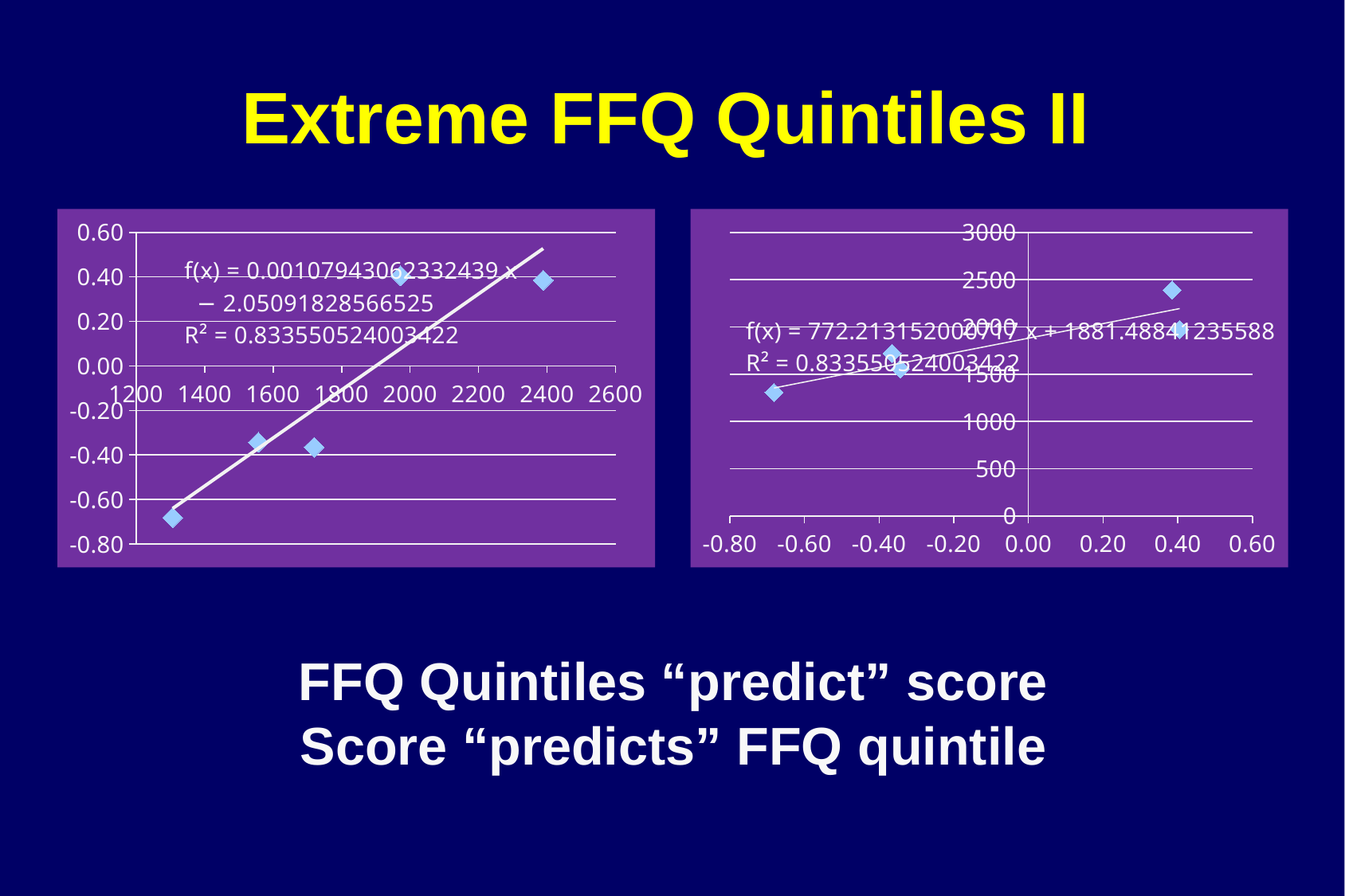
In the right chart, is the y value of the highest point greater or less than 2000? greater In the left chart, do the plotted values generally rise or fall as the x-axis value increases? rise What is the maximum value shown on the y-axis of the right chart? 3000 In the left chart, is the y value of the leftmost point (near x = 1300) greater or less than -0.60? less In the right chart, what R² value is printed on the chart? 0.833550524003422 What kind of chart is the right chart on the slide? scatter chart In the right chart, do the plotted values generally rise or fall as the x-axis value increases? rise In the right chart, is the y value of the leftmost point (near x = -0.70) greater or less than 1500? less What kind of chart is the left chart on the slide? scatter chart In the left chart, what R² value is printed on the chart? 0.833550524003422 How many data points are plotted in the left chart? 5 How many data points are plotted in the right chart? 5